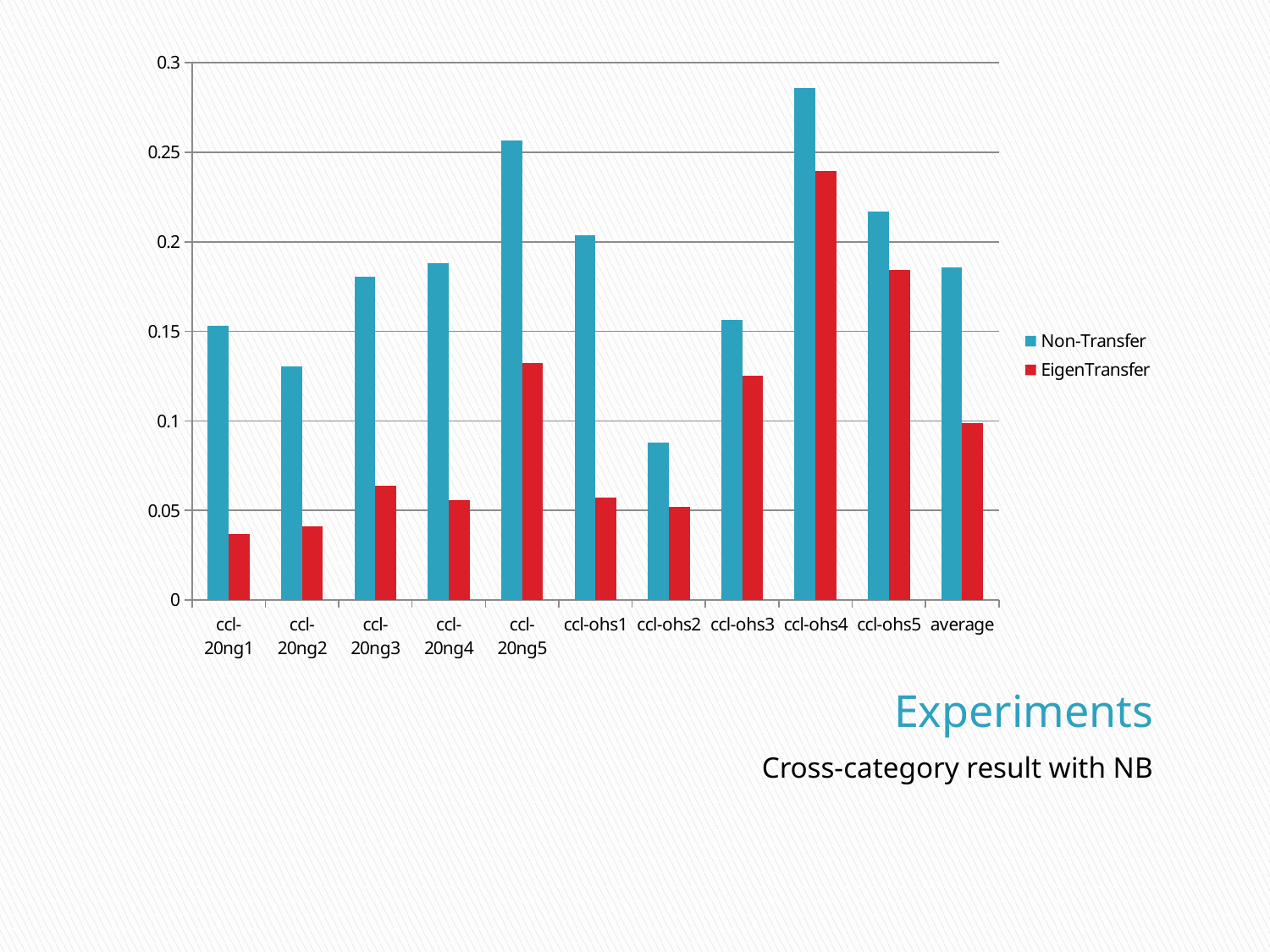
Is the Non-Transfer value for ccl-ohs2 greater or less than 0.1? less Is the EigenTransfer value for ccl-ohs5 greater or less than 0.15? greater Is the Non-Transfer value for ccl-ohs4 greater or less than 0.25? greater Which category has the lowest Non-Transfer value? ccl-ohs2 Which series is shown in red in the legend? EigenTransfer Which category has the highest EigenTransfer value? ccl-ohs4 Which category has the highest Non-Transfer value? ccl-ohs4 For ccl-20ng3, which series has the larger value, Non-Transfer or EigenTransfer? Non-Transfer How many series does the legend list? 2 What kind of chart is shown on the slide? bar chart How many categories are shown along the x axis? 11